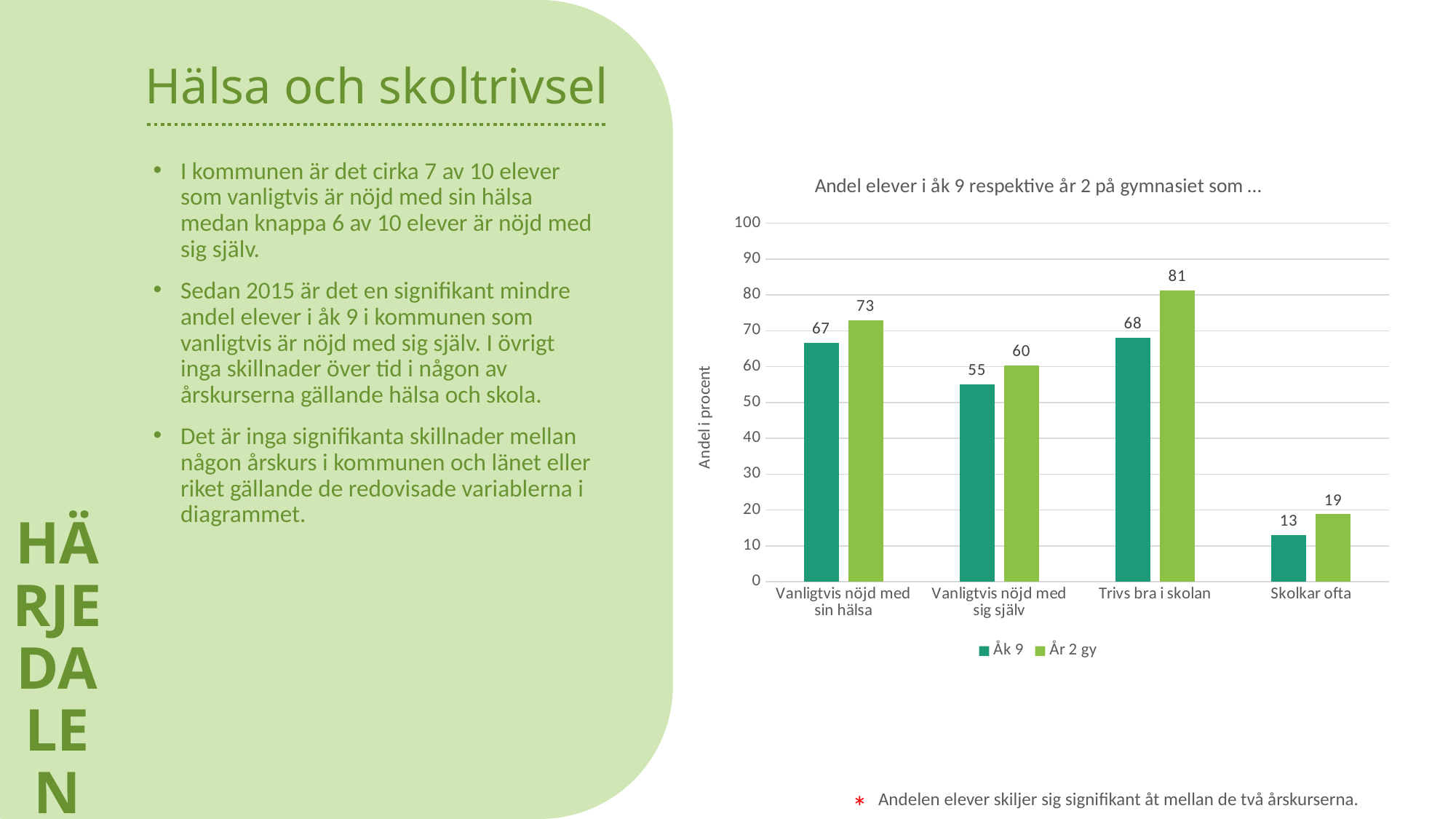
Which category has the lowest value for Åk 9? Skolkar ofta Which category has the highest value for År 2 gy? Trivs bra i skolan How many categories are shown on the x axis? 4 What is the difference between År 2 gy and Åk 9 in the category 'Trivs bra i skolan'? 13 What kind of chart is shown on the slide? Bar chart What is the value for År 2 gy in the category 'Trivs bra i skolan'? 81 What is the label of the y axis? Andel i procent What is the value for Åk 9 in the category 'Skolkar ofta'? 13 What is the value for Åk 9 in the category 'Vanligtvis nöjd med sin hälsa'? 67 What is the title of the chart? Andel elever i åk 9 respektive år 2 på gymnasiet som … Which is larger in the category 'Vanligtvis nöjd med sig själv': Åk 9 or År 2 gy? År 2 gy How many series does the legend list? 2